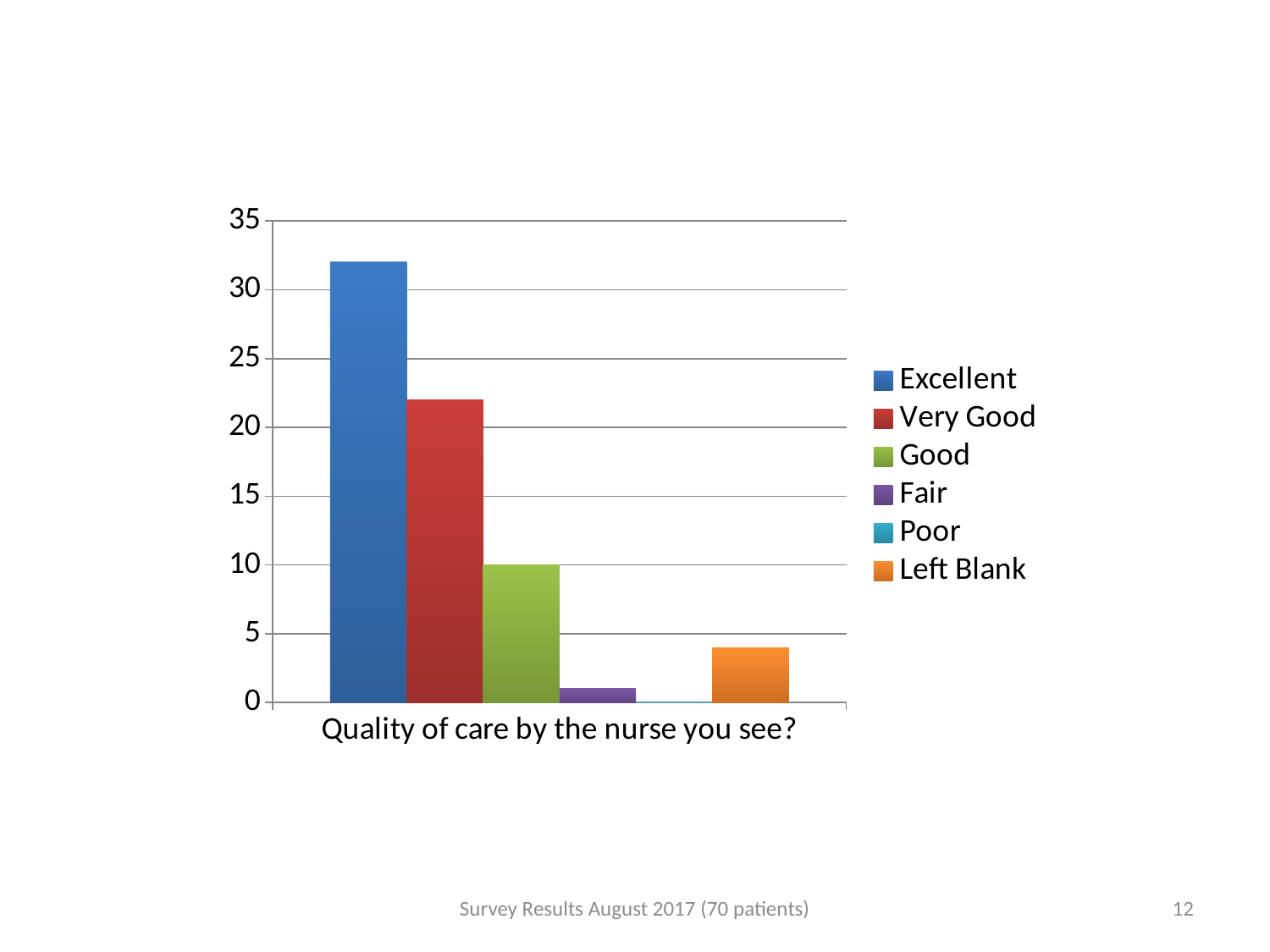
What is the value for Good? 10 What colour is the bar for Left Blank? orange Which is larger, the value for Left Blank or the value for Fair? Left Blank Which is larger, the value for Very Good or the value for Good? Very Good Is the value for Excellent greater or less than 30? greater What kind of chart is shown on the slide? bar chart Is the value for Very Good greater or less than 20? greater What is the label shown beneath the bars on the x axis? Quality of care by the nurse you see? How many series does the legend list? 6 Which category has the highest value? Excellent Is the value for Left Blank greater or less than 5? less Which category has the lowest value? Poor